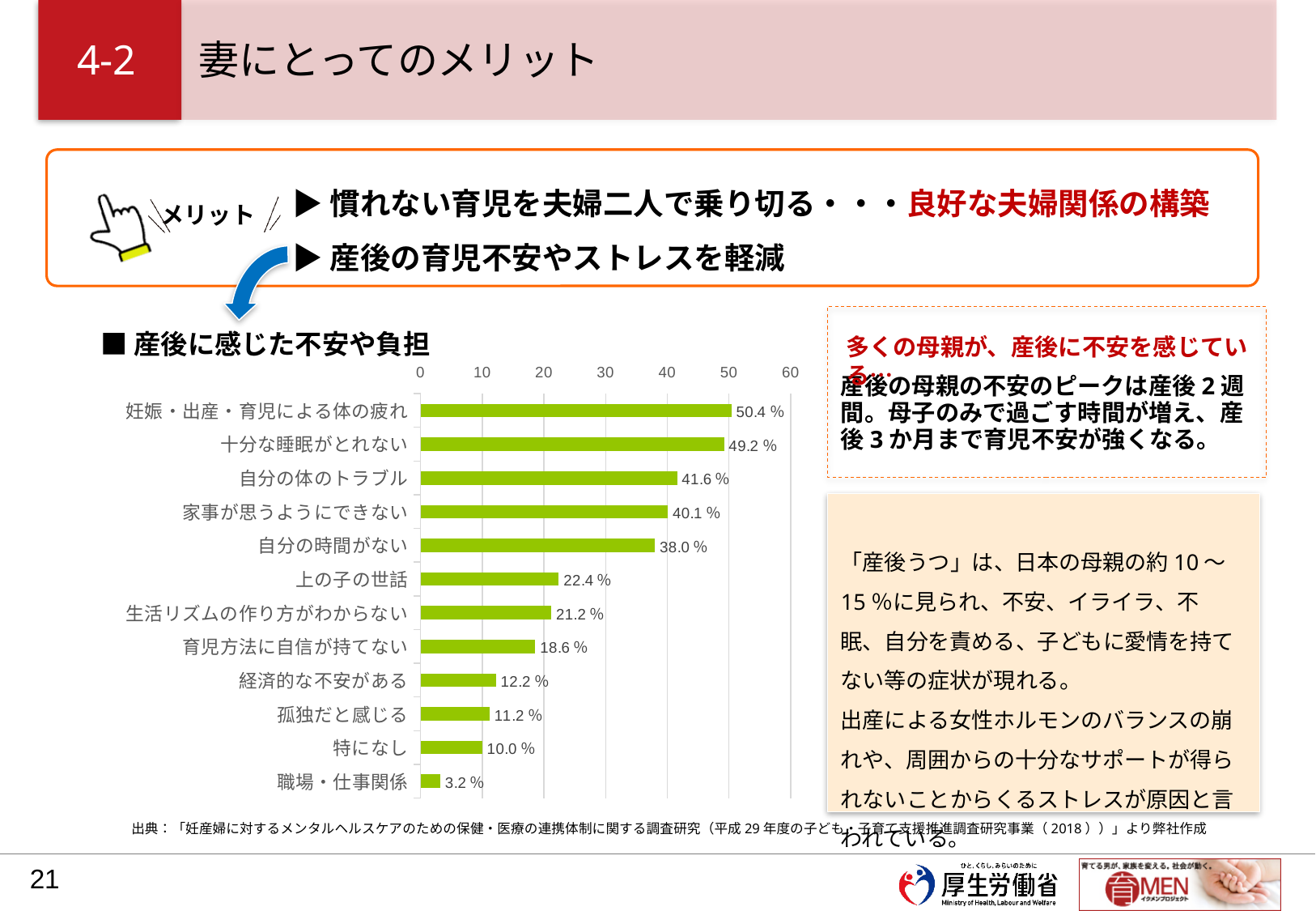
How many categories are shown in the chart? 12 Which category has the lowest value? 職場・仕事関係 Which category has the highest value? 妊娠・出産・育児による体の疲れ What is the value for 妊娠・出産・育児による体の疲れ? 50.4 % Is the value for 家事が思うようにできない greater or less than 30? greater What kind of chart is shown on the slide? bar chart What is the value for 孤独だと感じる? 11.2 % What is the value for 自分の時間がない? 38.0 % What is the title of the chart? 産後に感じた不安や負担 Which is larger, 上の子の世話 or 生活リズムの作り方がわからない? 上の子の世話 What is the difference between 経済的な不安がある and 特になし? 2.2 % What is the difference between 十分な睡眠がとれない and 自分の体のトラブル? 7.6 %